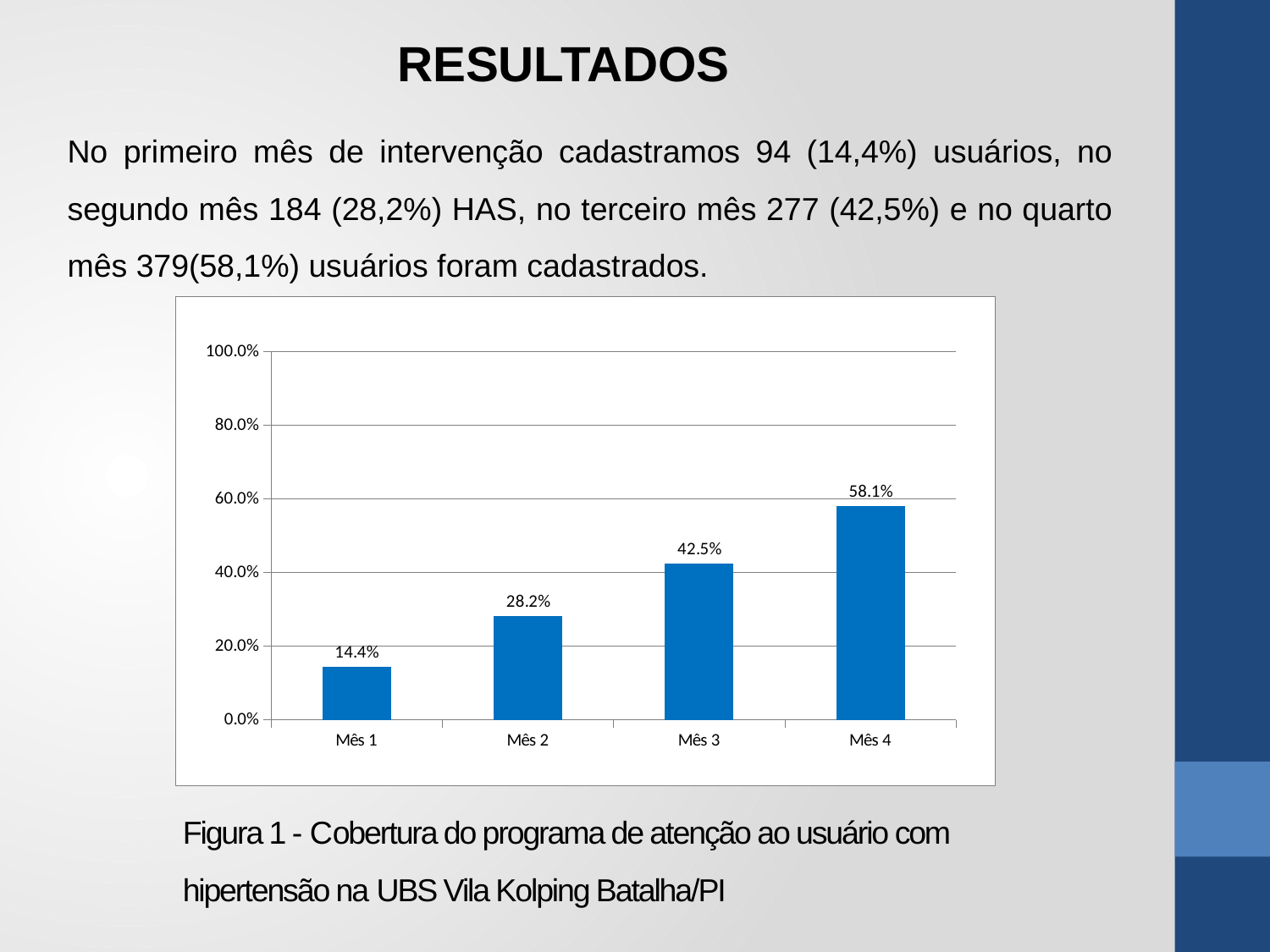
Is the value for Mês 4 greater or less than 60.0%? less What is the difference between the values for Mês 2 and Mês 1? 13.8% How many months are shown on the x axis? 4 Which month has the lowest value? Mês 1 Which month has the highest value? Mês 4 Do the values rise or fall from Mês 1 to Mês 4? rise What kind of chart is shown on the slide? bar chart Which is larger, the value for Mês 2 or the value for Mês 3? Mês 3 What is the value for Mês 3? 42.5% What is the value for Mês 4? 58.1% What is the difference between the values for Mês 4 and Mês 3? 15.6% What is the value for Mês 1? 14.4%